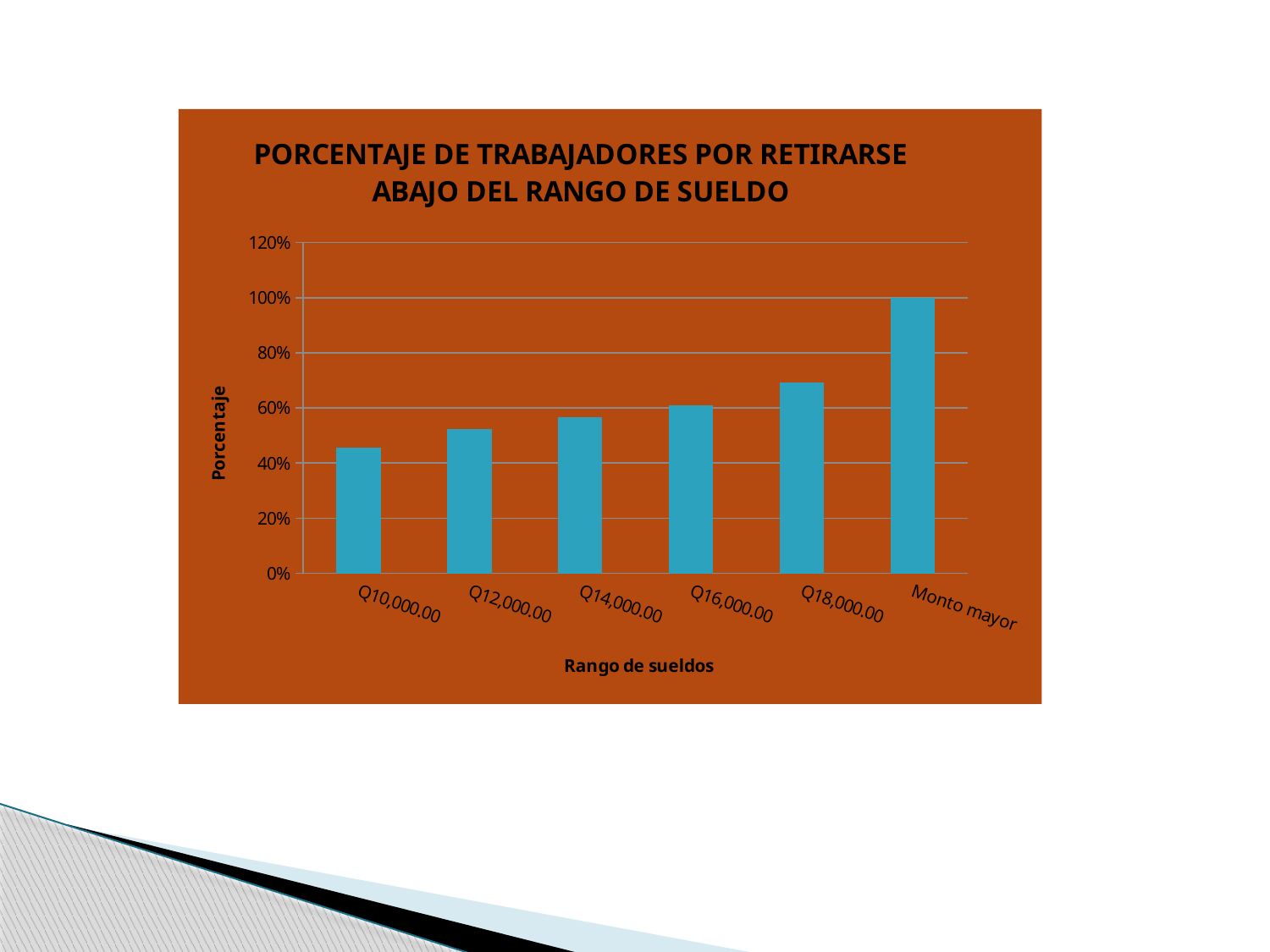
What kind of chart is shown on the slide? bar chart How many salary range categories are plotted on the x axis? 6 What is the label of the x axis? Rango de sueldos Is the value for Q16,000.00 greater or less than 40%? greater Which category has the lowest percentage? Q10,000.00 Is the value for Q10,000.00 greater or less than 60%? less Do the values rise or fall moving from Q10,000.00 to Monto mayor along the x axis? rise Is the value for Q12,000.00 greater or less than 40%? greater Which is larger, the value for Q18,000.00 or the value for Q12,000.00? Q18,000.00 Which category has the highest percentage? Monto mayor What is the percentage for Monto mayor? 100%